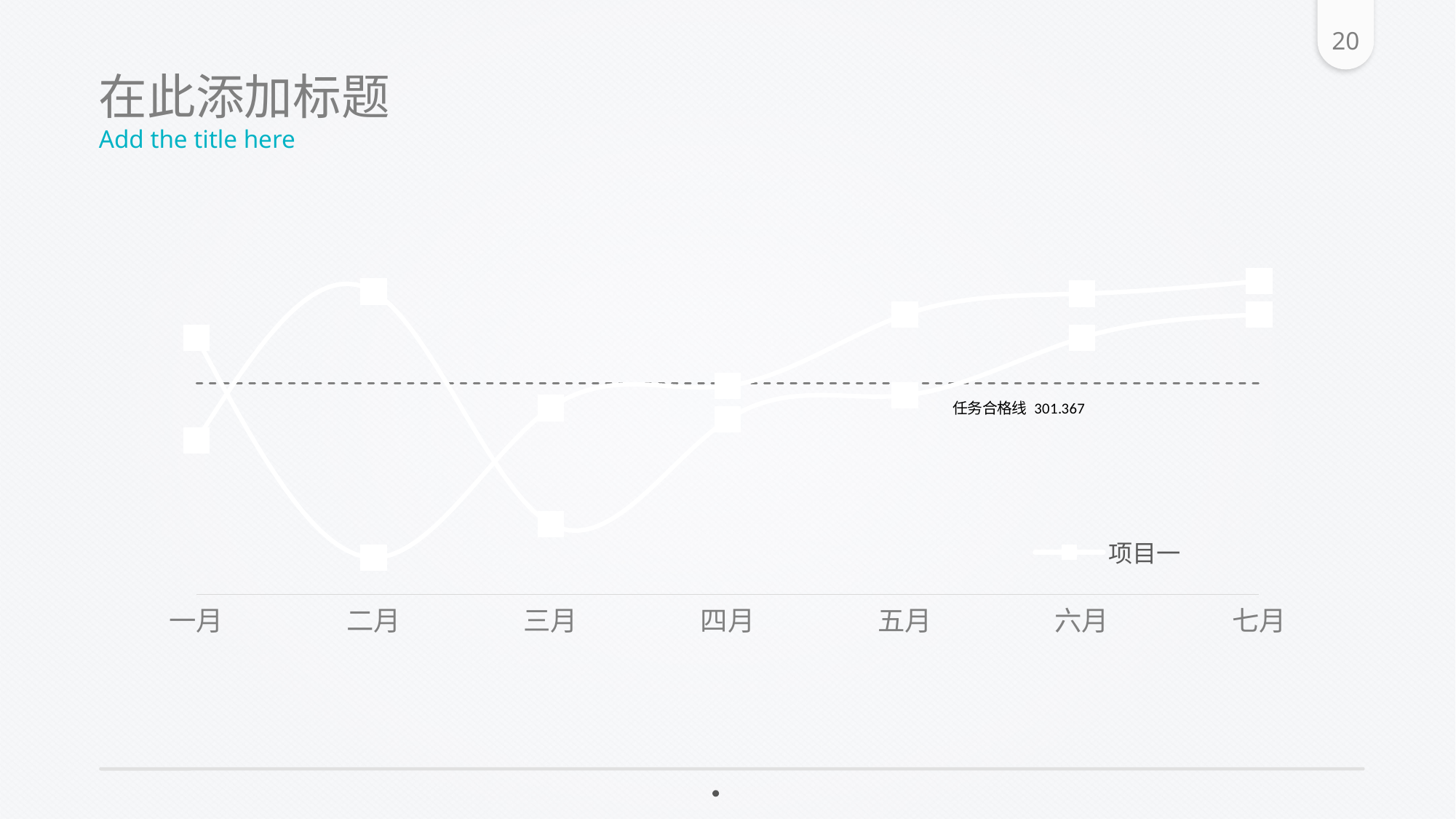
What kind of chart is shown on the slide? line chart Are the plotted values for 七月 greater or less than the 任务合格线 value of 301.367? greater What is the first category on the x axis of the chart? 一月 Are the plotted values for 三月 greater or less than the 任务合格线 value of 301.367? less What value is printed next to the dashed horizontal reference line (任务合格线) on the chart? 301.367 What is the last category on the x axis of the chart? 七月 What is the name of the series listed in the chart's legend? 项目一 How many categories are shown on the x axis of the chart? 7 How many series does the chart's legend list? 1 Are the plotted values for 六月 greater or less than the 任务合格线 value of 301.367? greater